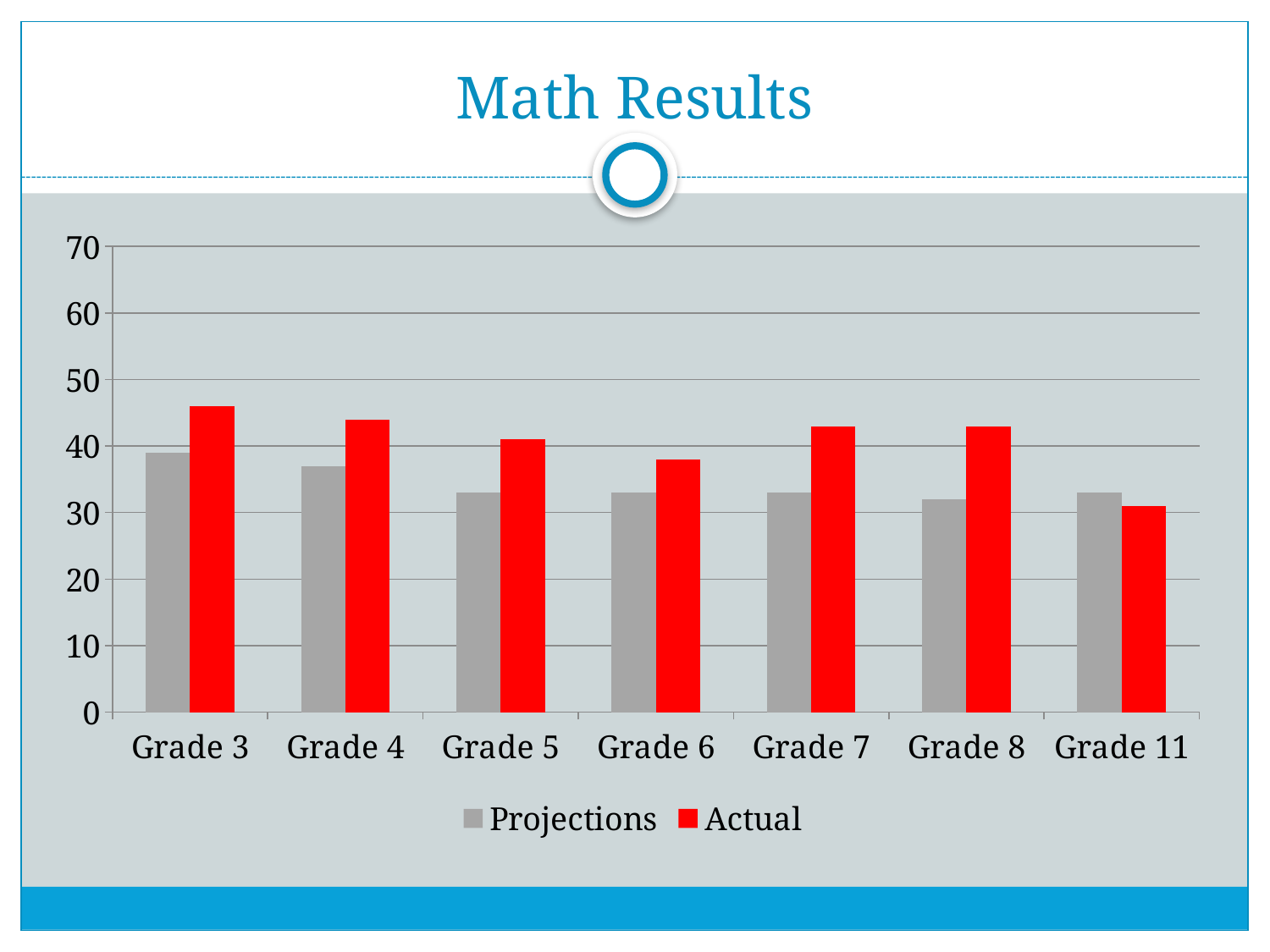
For Grade 3, which is larger, Projections or Actual? Actual Which is larger, the Actual value for Grade 6 or the Actual value for Grade 7? Grade 7 Is the Projections value for Grade 5 greater or less than 40? less How many series does the legend list? 2 Is the Actual value for Grade 11 greater or less than 40? less Is the Actual value for Grade 3 greater or less than 40? greater Which grade has the lowest Actual value? Grade 11 What kind of chart is shown on the slide? bar chart What is the title of the chart? Math Results How many grade categories are shown on the x axis? 7 Which colour represents the Actual series? red